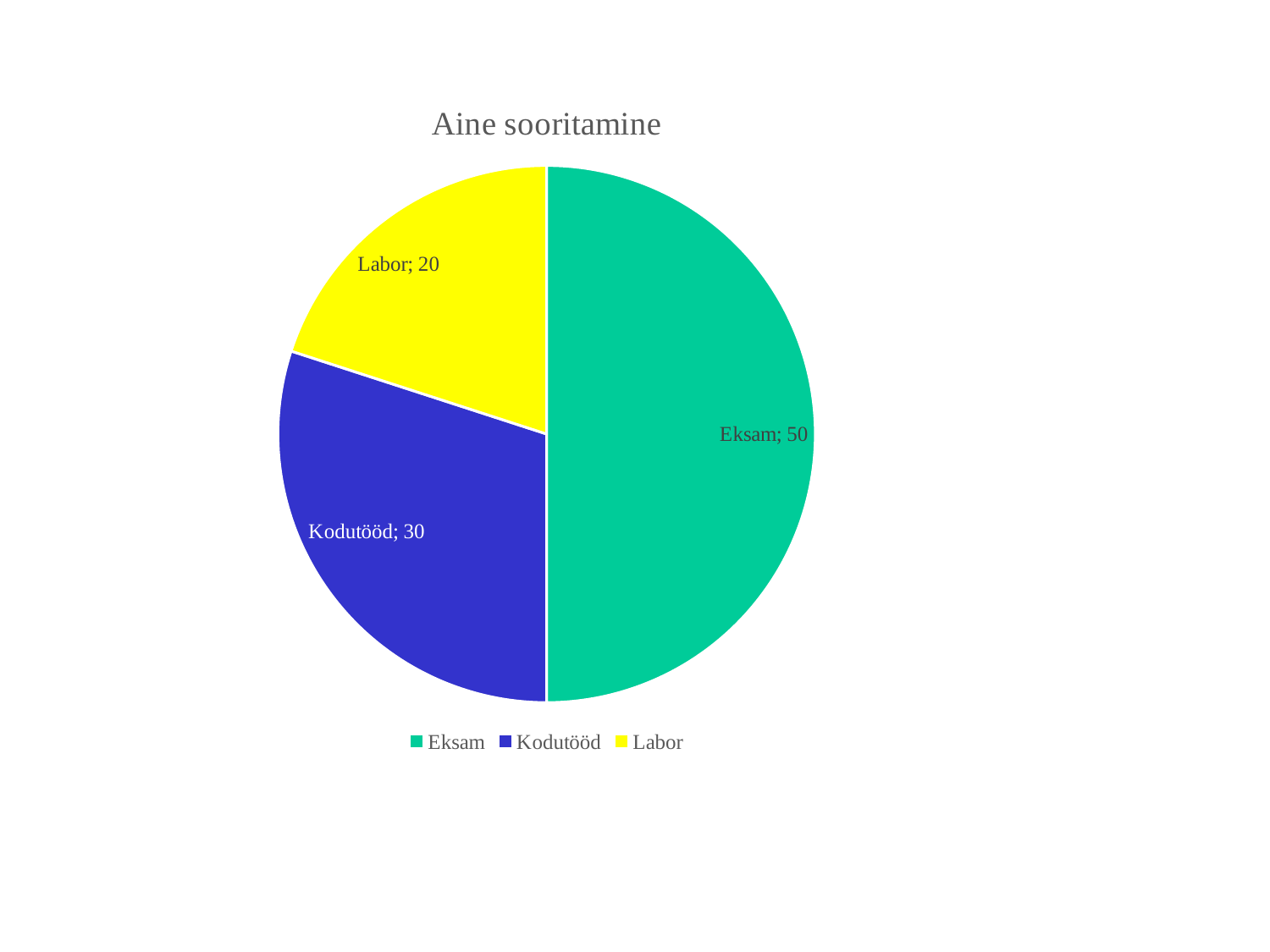
Which is larger, the value for Kodutööd or the value for Labor? Kodutööd Which category has the largest slice? Eksam What kind of chart is shown on the slide? pie chart What is the value for Labor? 20 How many slices does the pie chart have? 3 What is the title of the chart? Aine sooritamine Which category has the smallest slice? Labor What is the value for Eksam? 50 What is the difference between the values for Eksam and Kodutööd? 20 What share of the pie does the Eksam slice represent? 50% What colour is the Labor slice? yellow What is the value for Kodutööd? 30